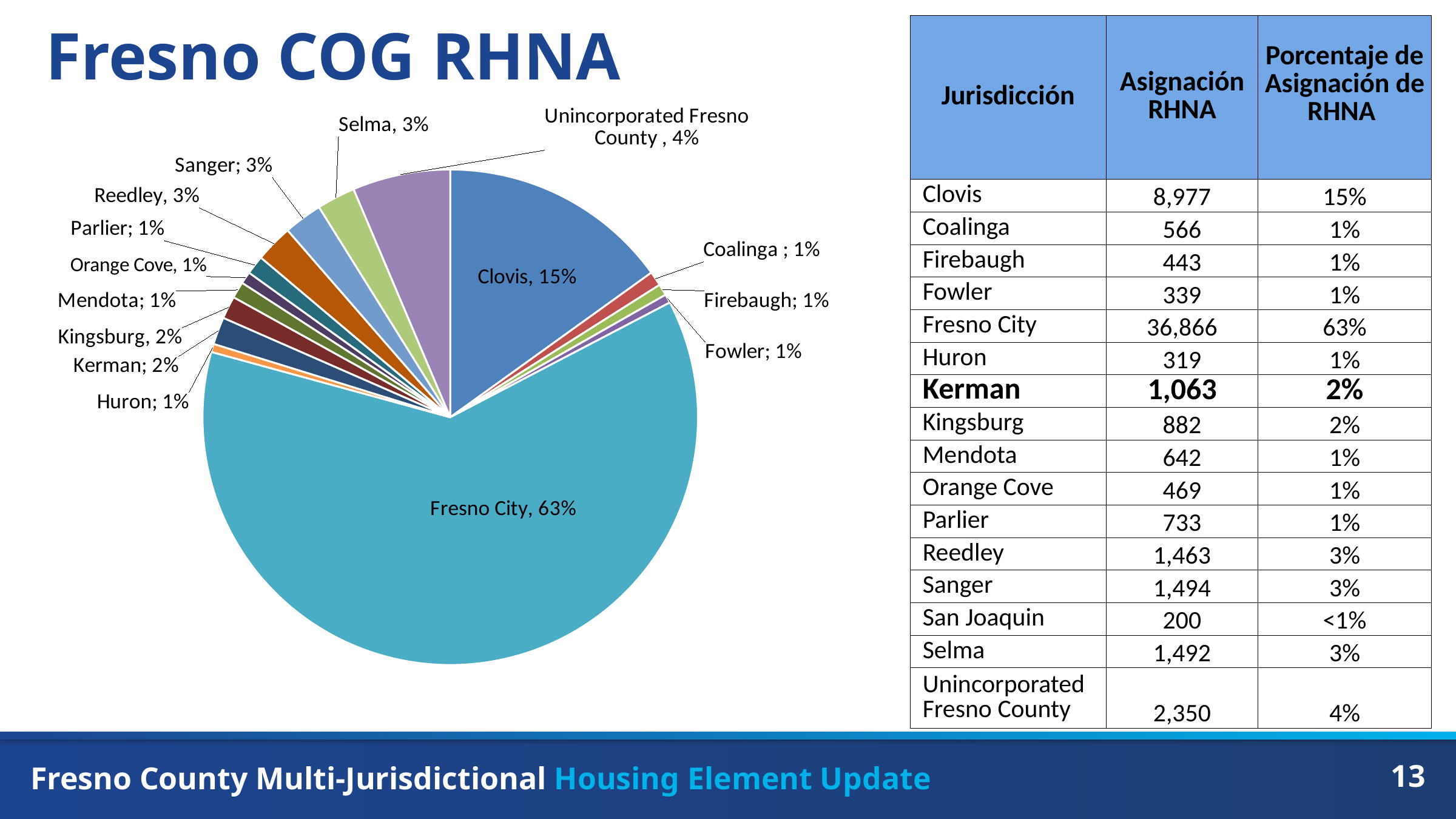
By how many percentage points does Fresno City's share exceed Clovis's share in the pie chart? 48% Which has a larger share in the pie chart, Kingsburg or Reedley? Reedley What percentage is shown for Unincorporated Fresno County in the pie chart? 4% What share of the pie does Fresno City account for? 63% Which jurisdiction has the largest slice of the pie chart? Fresno City What percentage is shown for Kerman in the pie chart? 2% What percentage is shown for Selma in the pie chart? 3% What percentage is shown for Huron in the pie chart? 1% What is the title of the slide containing the pie chart? Fresno COG RHNA Which has a larger share in the pie chart, Unincorporated Fresno County or Sanger? Unincorporated Fresno County What share of the pie does Clovis account for? 15% What kind of chart is shown on the slide? pie chart